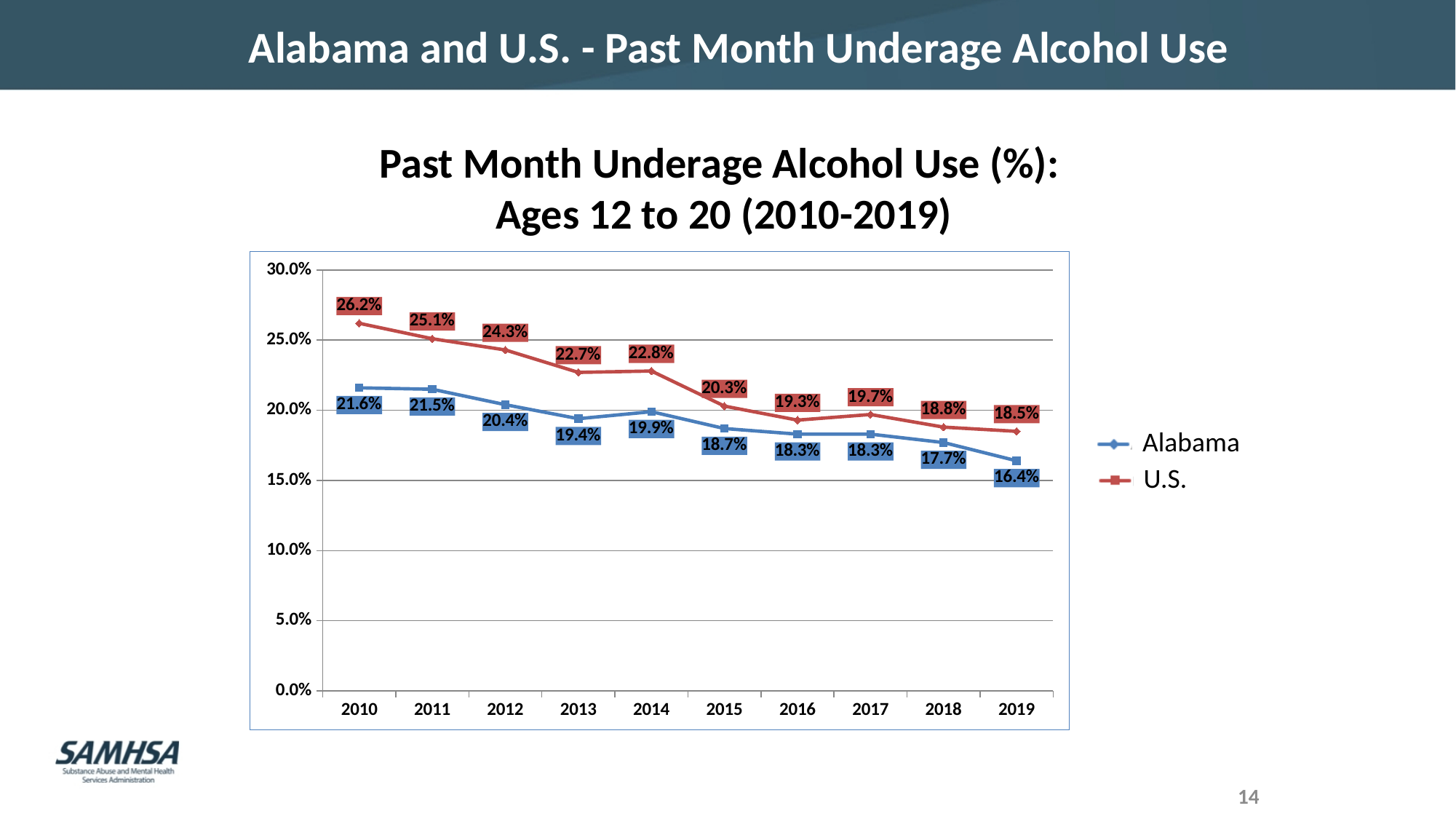
What is the difference between the U.S. and Alabama values in 2010? 4.6% How many years are shown on the x axis? 10 What kind of chart is shown on the slide? Line chart What was the U.S. past month underage alcohol use rate in 2015? 20.3% In which year was the U.S. value highest? 2010 Is the U.S. value for 2012 greater or less than 20.0%? greater In which year was the Alabama value lowest? 2019 How many series does the legend list? 2 Which was higher in 2017, Alabama or U.S.? U.S. What was the Alabama value in 2019? 16.4% What was the past month underage alcohol use rate for Alabama in 2010? 21.6% What is the overall trend of the Alabama series from 2010 to 2019? Falling